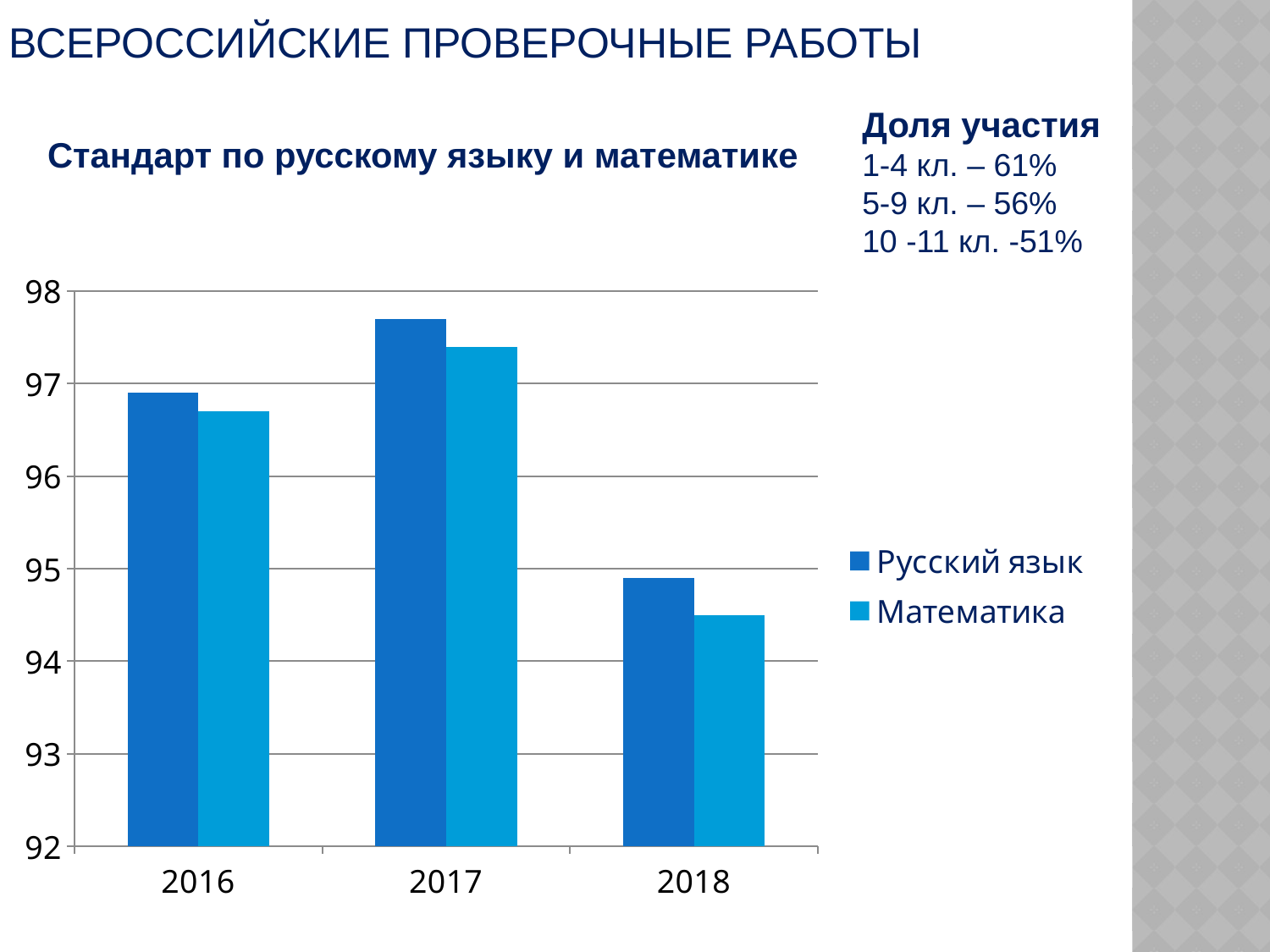
Is the value for Русский язык in 2017 greater or less than 97? greater In which year is the value for Русский язык highest? 2017 In which year is the value for Математика lowest? 2018 How many years are shown on the x axis of the chart? 3 Is the value for Математика in 2018 greater or less than 95? less What is the title of the chart? Стандарт по русскому языку и математике Which is larger: the value for Русский язык in 2017 or in 2018? 2017 What kind of chart is shown on the slide? bar chart How many series does the chart legend list? 2 What are the two series named in the chart legend? Русский язык, Математика From 2017 to 2018, does the value for Математика rise or fall? fall Is the value for Математика in 2016 greater or less than 96? greater